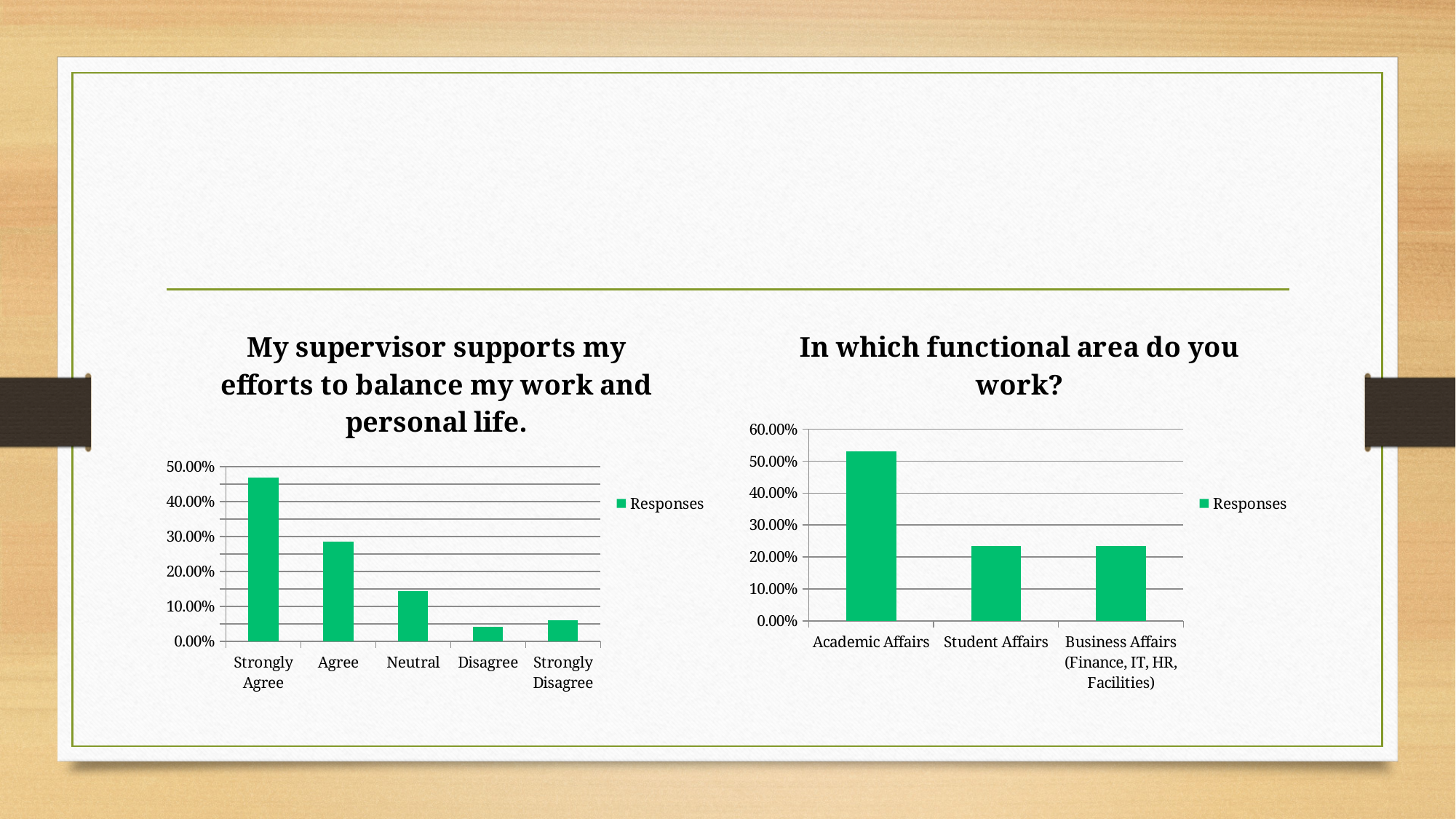
In the right chart, "In which functional area do you work?", which category has the highest value? Academic Affairs In the left chart, "My supervisor supports my efforts to balance my work and personal life.", is the value for Neutral greater or less than 20.00%? less In the left chart, "My supervisor supports my efforts to balance my work and personal life.", which category has the highest value? Strongly Agree How many categories are shown on the x axis of the right chart, "In which functional area do you work?"? 3 In the left chart, "My supervisor supports my efforts to balance my work and personal life.", which category has the lowest value? Disagree What is the name of the series shown in the legend of the left chart, "My supervisor supports my efforts to balance my work and personal life."? Responses How many categories are shown on the x axis of the left chart, "My supervisor supports my efforts to balance my work and personal life."? 5 What kind of chart is the left chart titled "My supervisor supports my efforts to balance my work and personal life."? bar chart How many series does the legend of the right chart, "In which functional area do you work?", list? 1 In the right chart, "In which functional area do you work?", is the value for Academic Affairs greater or less than 50.00%? greater In the left chart, "My supervisor supports my efforts to balance my work and personal life.", which is larger, the value for Agree or the value for Neutral? Agree In the left chart, "My supervisor supports my efforts to balance my work and personal life.", is the value for Strongly Agree greater or less than 40.00%? greater